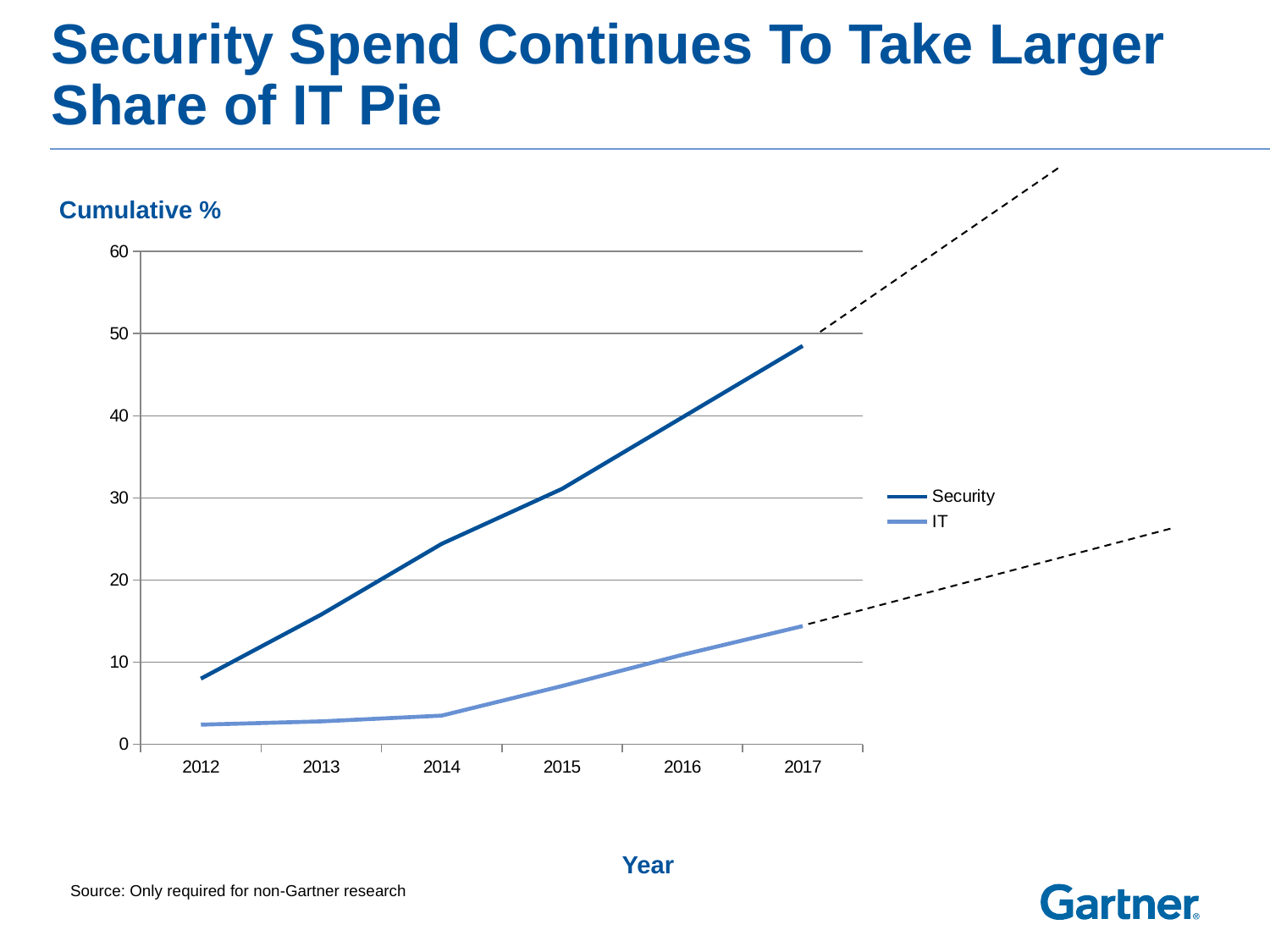
What is the label on the vertical axis of the chart? Cumulative % Which series has the larger value in 2017, Security or IT? Security Is the IT value for 2014 greater or less than 10? less Is the Security value for 2017 greater or less than 40? greater Is the Security value for 2016 greater or less than 30? greater How many years are shown on the x axis? 6 Does the Security line rise or fall from 2012 to 2017? rise In which year is the Security value highest? 2017 In which year is the IT value lowest? 2012 What kind of chart is shown on the slide? line chart How many series does the legend list? 2